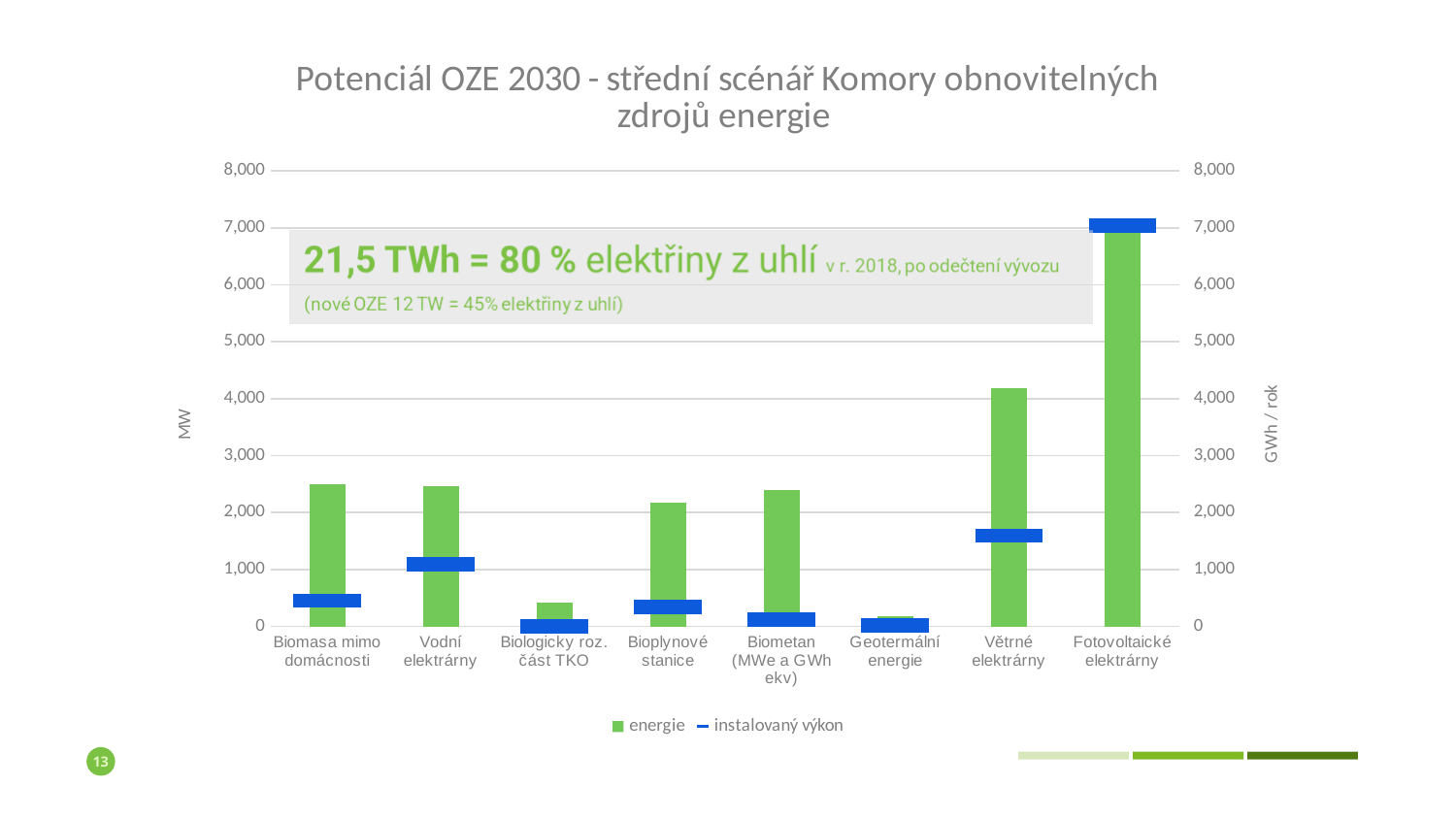
What is the label on the right-hand vertical axis of the chart? GWh / rok Which category has the highest energie value? Fotovoltaické elektrárny How many series does the chart legend list? 2 Is the energie value for Biologicky roz. část TKO greater or less than 1,000? less Is the energie value for Větrné elektrárny greater or less than 3,000? greater Which has the larger energie value, Větrné elektrárny or Biomasa mimo domácnosti? Větrné elektrárny Which category has the lowest energie value? Geotermální energie How many categories are shown on the x axis of the chart? 8 What are the two series named in the chart legend? energie and instalovaný výkon Is the energie value for Fotovoltaické elektrárny greater or less than 6,000? greater What kind of chart is shown on the slide? bar chart